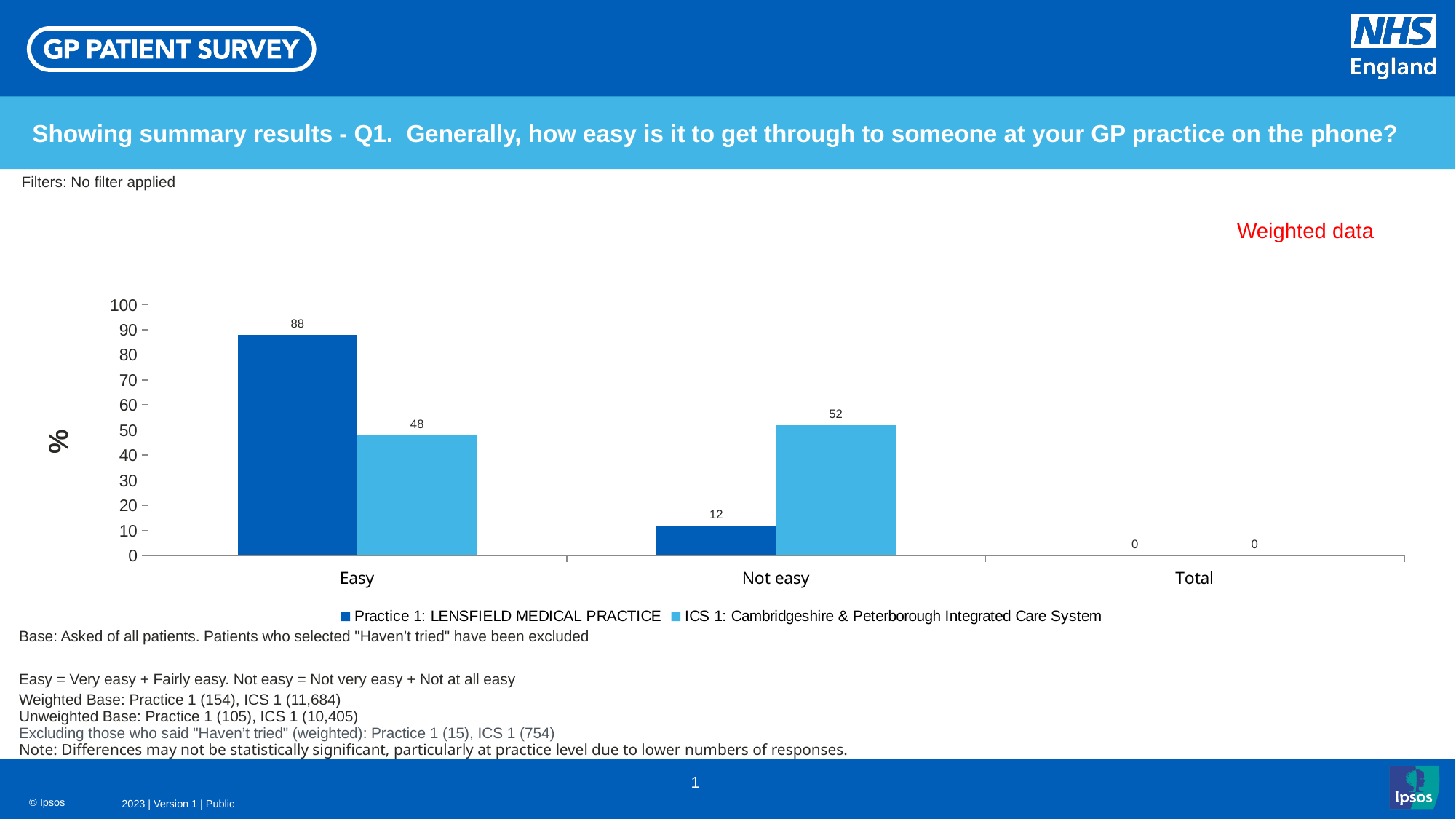
What is the value for ICS 1: Cambridgeshire & Peterborough Integrated Care System in the Easy category? 48 What is the difference between the Practice 1 and ICS 1 values in the Easy category? 40 What is the value for Practice 1: LENSFIELD MEDICAL PRACTICE in the Easy category? 88 What is the difference between the ICS 1 and Practice 1 values in the Not easy category? 40 Which series has the larger value in the Not easy category, Practice 1 or ICS 1? ICS 1: Cambridgeshire & Peterborough Integrated Care System Which category has the highest value for Practice 1: LENSFIELD MEDICAL PRACTICE? Easy What is the value for ICS 1: Cambridgeshire & Peterborough Integrated Care System in the Not easy category? 52 How many series does the legend list? 2 What is the value for Practice 1: LENSFIELD MEDICAL PRACTICE in the Not easy category? 12 What kind of chart is shown on the slide? Bar chart Which series has the larger value in the Easy category, Practice 1 or ICS 1? Practice 1: LENSFIELD MEDICAL PRACTICE What is the label on the vertical axis of the chart? %